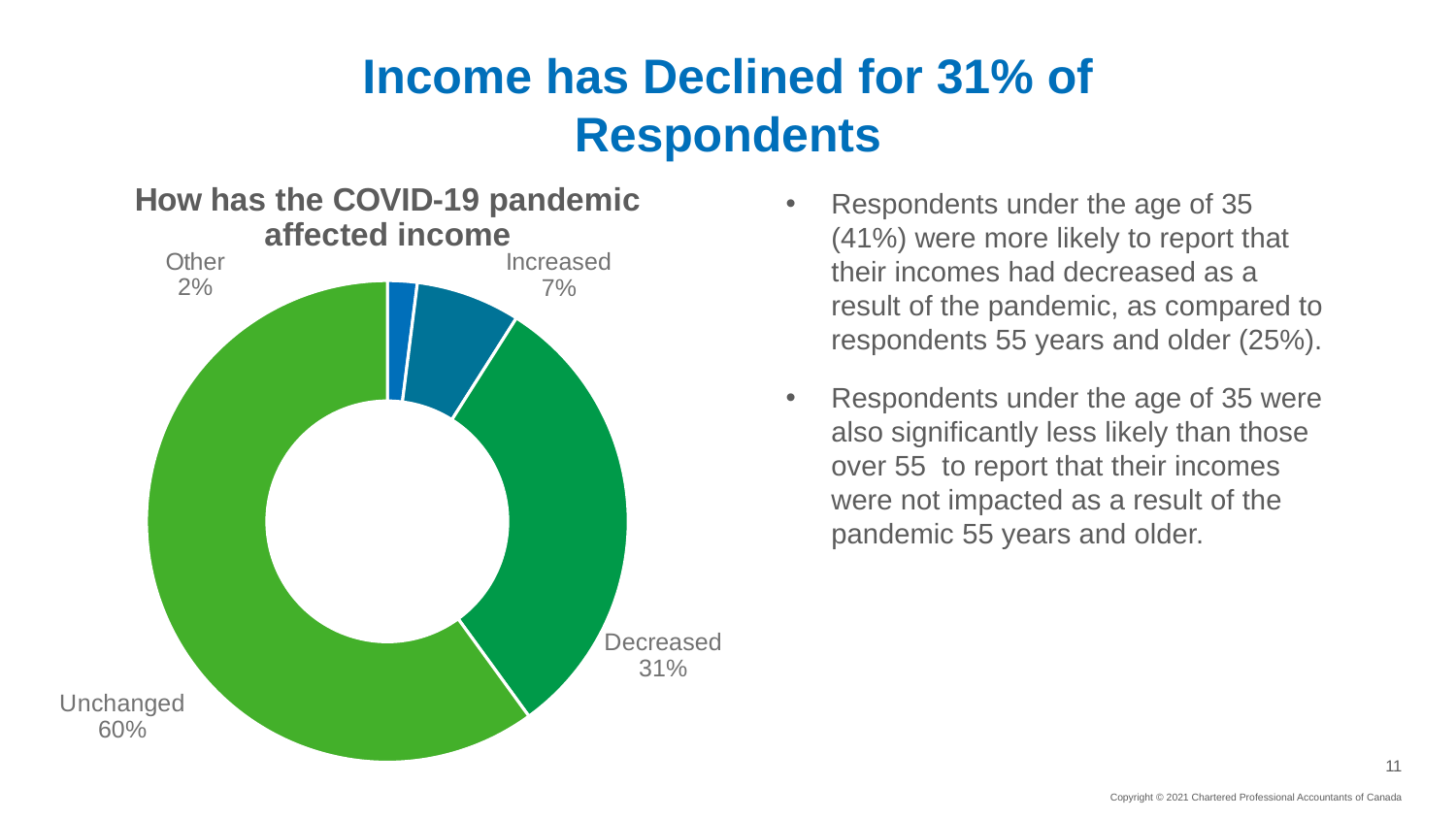
Which category has the largest share of the chart? Unchanged Which is larger, the share for Increased or the share for Decreased? Decreased Which category has the smallest share of the chart? Other What percentage of respondents reported their income Decreased? 31% What percentage of respondents reported their income was Unchanged? 60% What is the difference in percentage points between Unchanged and Decreased? 29 What is the title of the chart? How has the COVID-19 pandemic affected income How many categories are shown in the chart? 4 What is the combined share of Increased and Other? 9% What percentage of respondents reported their income Increased? 7% What percentage of respondents answered Other? 2% What kind of chart is shown on the slide? Pie chart (doughnut)